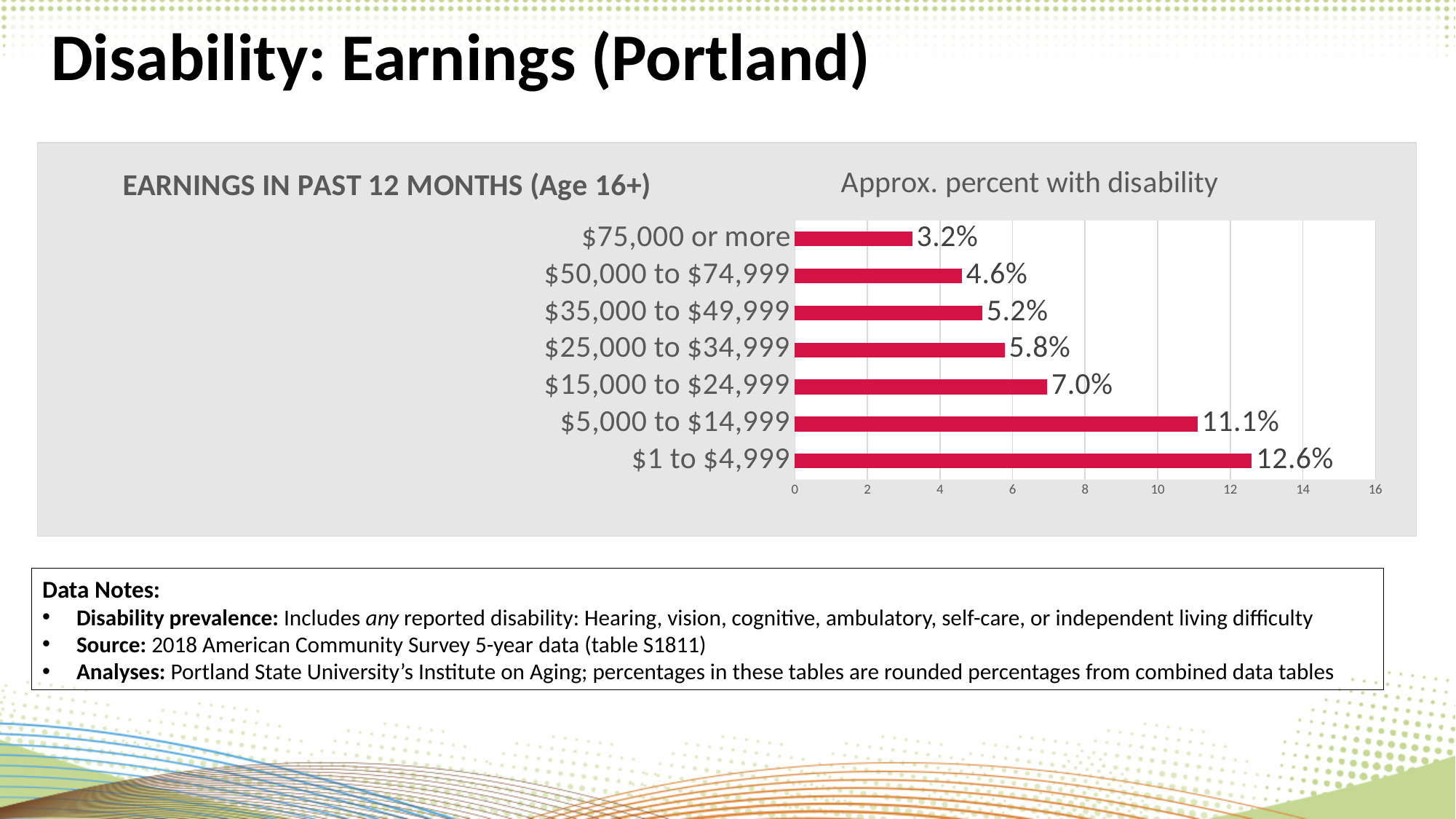
How many earnings categories are shown in the chart? 7 What is the approximate percent with disability for the $75,000 or more earnings category? 3.2% What is the maximum value shown on the horizontal axis of the chart? 16 What is the title of the chart? EARNINGS IN PAST 12 MONTHS (Age 16+) What is the approximate percent with disability for the $1 to $4,999 earnings category? 12.6% Is the value for $5,000 to $14,999 greater or less than 10? greater What kind of chart is shown on the slide? bar chart What is the difference in percent with disability between the $5,000 to $14,999 and $25,000 to $34,999 categories? 5.3% Which has a higher percent with disability: $35,000 to $49,999 or $50,000 to $74,999? $35,000 to $49,999 What is the approximate percent with disability for the $15,000 to $24,999 earnings category? 7.0% Which earnings category has the lowest percent with disability? $75,000 or more Which earnings category has the highest percent with disability? $1 to $4,999